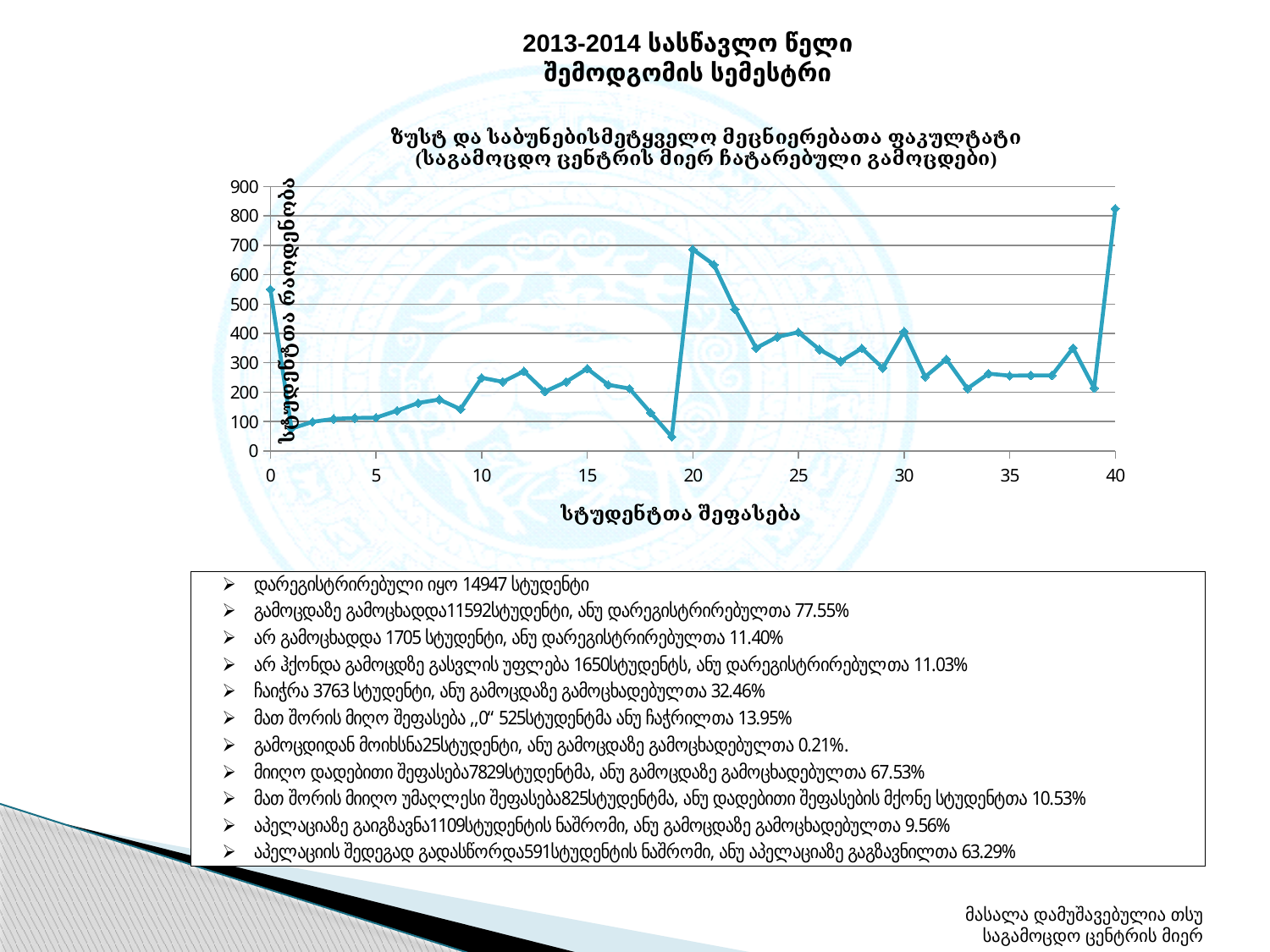
At which x-axis value (student grade) does the line reach its highest point? 40 Is the value at x = 20 greater or less than 600? greater Which is larger, the value at x = 20 or the value at x = 0? x = 20 Is the value at x = 0 greater or less than 400? greater What is the highest tick value shown on the y axis? 900 Between x = 20 and x = 23, do the values rise or fall? fall What is the title of the x axis? სტუდენტთა შეფასება Is the value at x = 19 greater or less than 100? less At which x-axis value (student grade) does the line reach its lowest point? 19 What kind of chart is shown on the slide? line chart